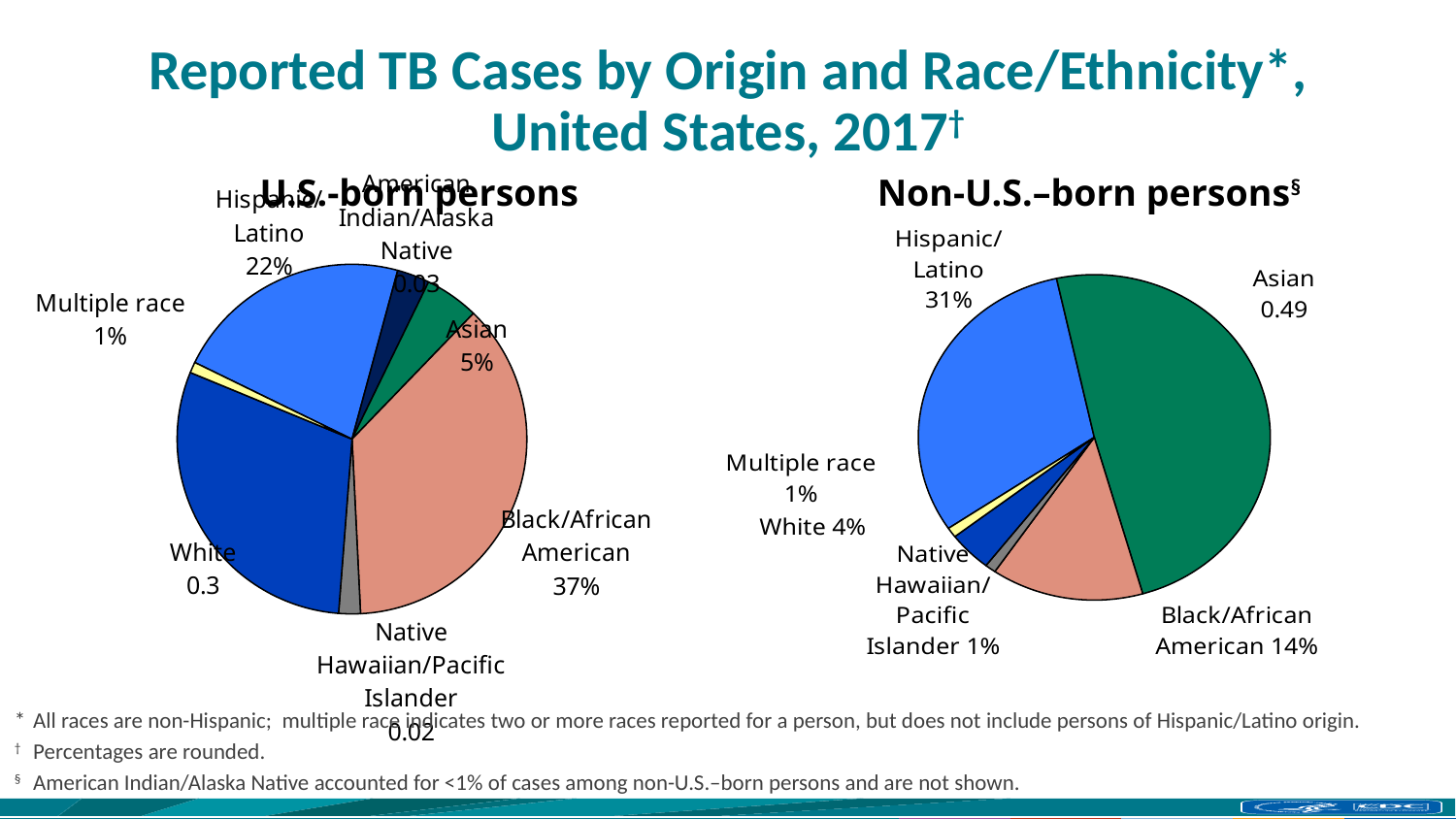
In the U.S.-born persons chart, what is the value for Hispanic/Latino? 22% In the Non-U.S.–born persons chart, what is the difference between Hispanic/Latino and Black/African American? 17% In the U.S.-born persons chart, what is the value for Asian? 5% In the Non-U.S.–born persons chart, which is larger, White or Black/African American? Black/African American In the U.S.-born persons chart, what value is printed for White? 0.3 In the U.S.-born persons chart, which category has the largest slice? Black/African American What kind of charts are shown on the slide? Pie charts In the Non-U.S.–born persons chart, what is the value for Hispanic/Latino? 31% In the Non-U.S.–born persons chart, what is the value for Black/African American? 14% In the U.S.-born persons chart, what is the value for Black/African American? 37% In the Non-U.S.–born persons chart, which category has the largest slice? Asian In the Non-U.S.–born persons chart, what value is printed for Asian? 0.49